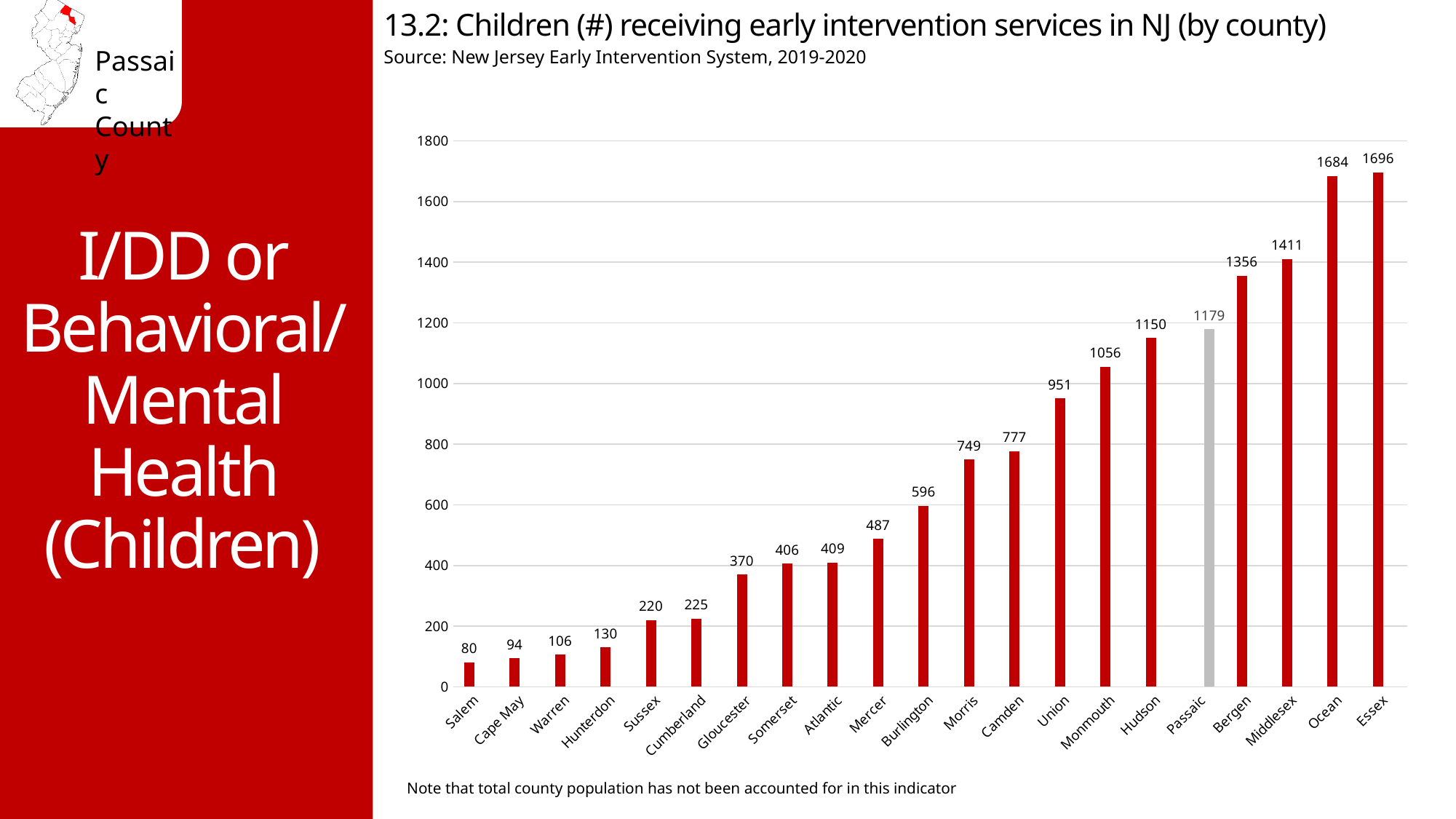
Which county's bar is shown in grey rather than red? Passaic Which county has the highest number of children receiving early intervention services? Essex What kind of chart is shown on the slide? Bar chart How many children received early intervention services in Passaic County? 1179 Is the value for Monmouth greater or less than 1000? greater What is the difference between the values for Essex and Ocean? 12 What is the value shown for Mercer? 487 Which county has a larger value, Morris or Union? Union Which county has the lowest number of children receiving early intervention services? Salem What is the value shown for Hudson? 1150 What is the difference between the values for Bergen and Passaic? 177 How many counties are shown on the chart? 21